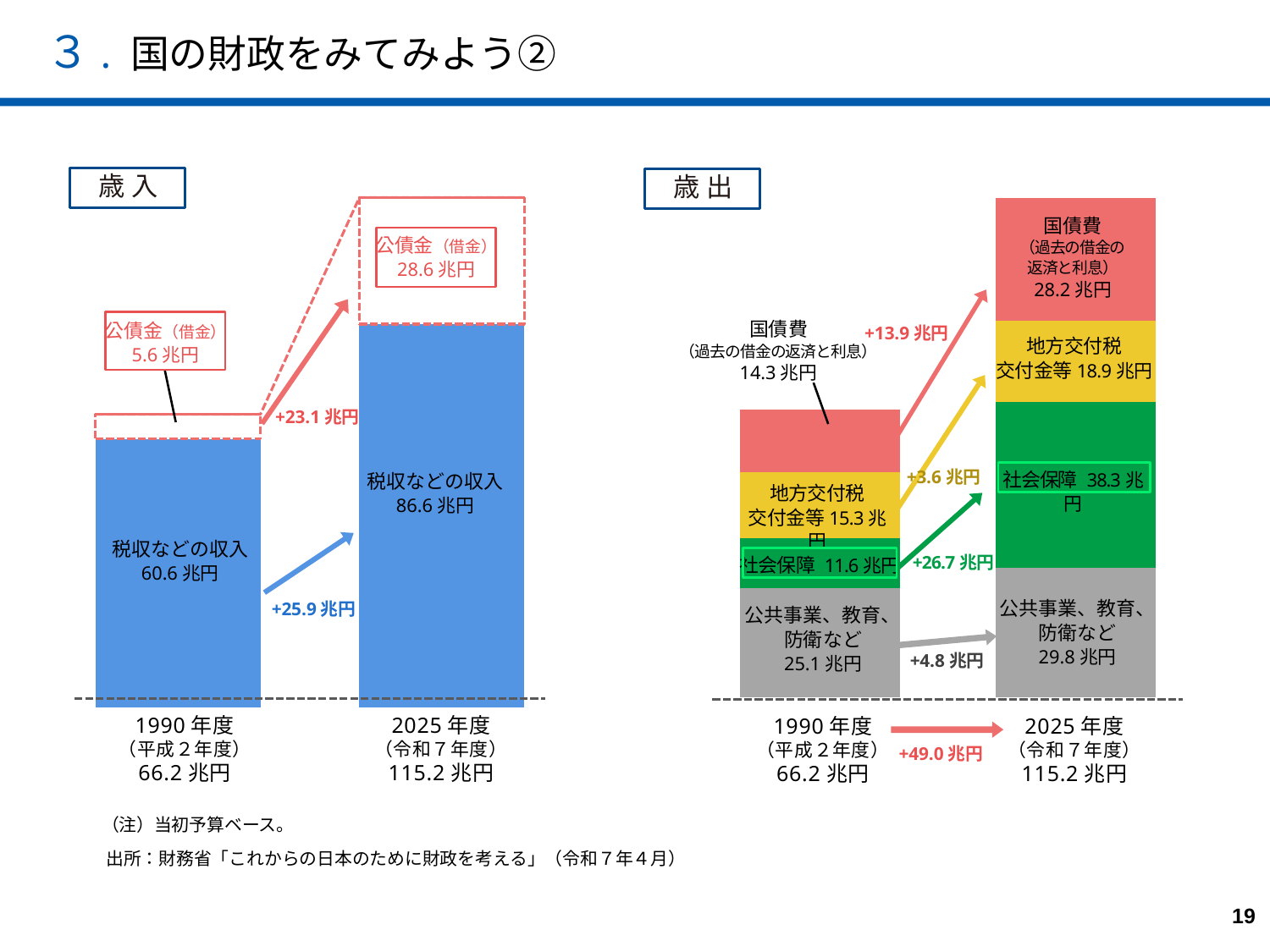
「歳入」のグラフで、1990年度から2025年度にかけて税収などの収入はいくら増えましたか？ +25.9兆円 「歳入」のグラフで、2025年度の公債金（借金）はいくらですか？ 28.6兆円 「歳出」のグラフで、2025年度の社会保障はいくらですか？ 38.3兆円 「歳出」のグラフで、1990年度から2025年度にかけて社会保障はいくら増えましたか？ +26.7兆円 「歳入」のグラフで、1990年度の税収などの収入はいくらですか？ 60.6兆円 「歳出」のグラフで、2025年度の歳出項目のうち最も金額が大きいのはどれですか？ 社会保障 「歳入」のグラフで、1990年度の公債金（借金）と2025年度の公債金（借金）ではどちらが大きいですか？ 2025年度 「歳出」のグラフは、各年度の棒をいくつの項目に分けて示していますか？ 4 「歳出」のグラフで、1990年度の歳出項目のうち最も金額が小さいのはどれですか？ 社会保障 「歳入」のグラフで、2025年度の歳入合計はいくらですか？ 115.2兆円 「歳出」のグラフで、1990年度の歳出合計はいくらですか？ 66.2兆円 「歳出」のグラフで、1990年度の国債費はいくらですか？ 14.3兆円